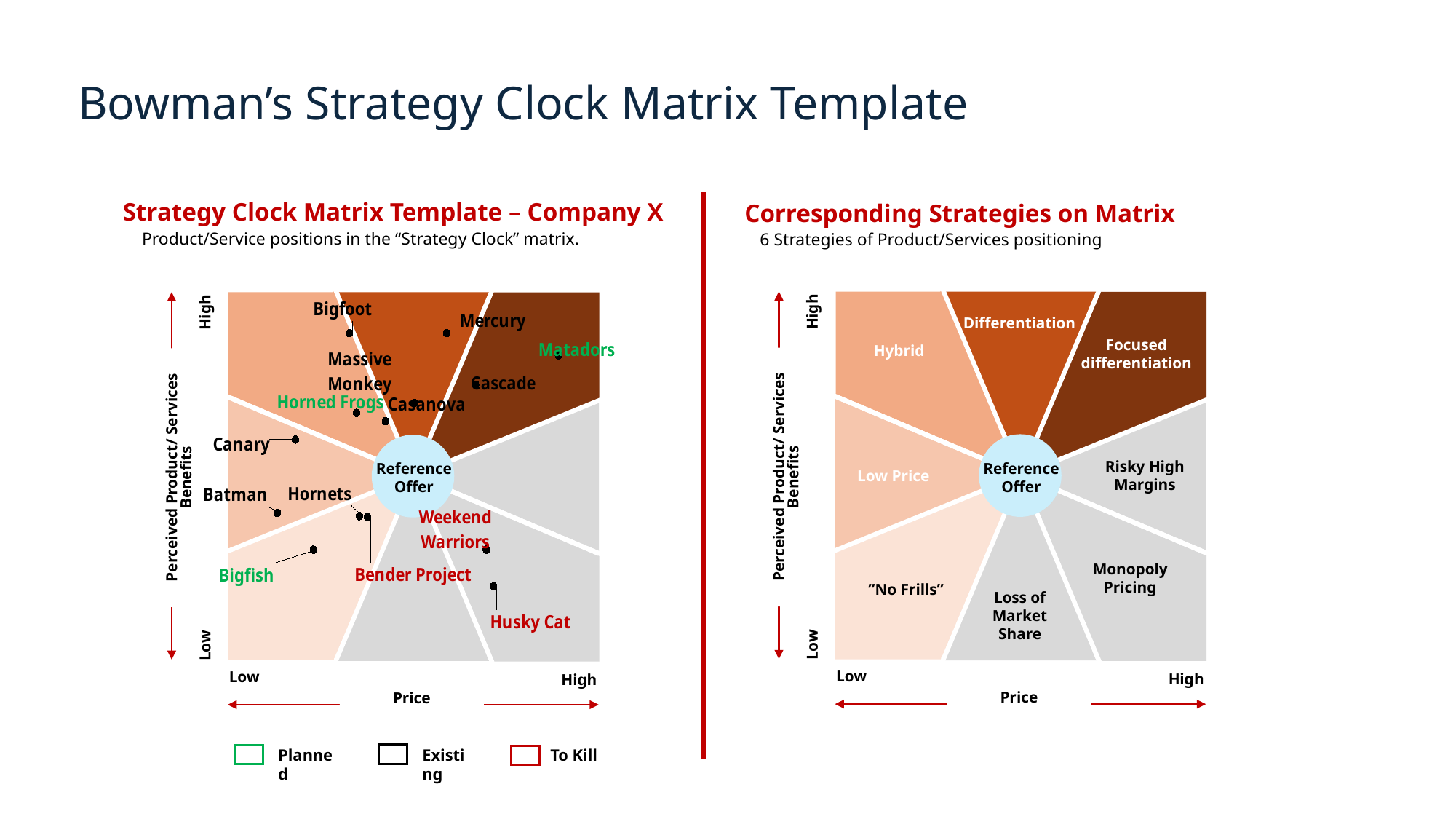
On the left chart (Strategy Clock Matrix Template – Company X), how many named products/services are plotted? 14 On the left chart (Strategy Clock Matrix Template – Company X), which products are shown in red as To Kill? Weekend Warriors, Bender Project, Husky Cat On the left chart (Strategy Clock Matrix Template – Company X), which product has the lowest perceived product/service benefits? Husky Cat On the left chart (Strategy Clock Matrix Template – Company X), how many entries does the legend list? 3 On the left chart (Strategy Clock Matrix Template – Company X), which product is positioned at the highest price? Matadors On the right chart (Corresponding Strategies on Matrix), how many strategy segments surround the Reference Offer? 8 On the right chart (Corresponding Strategies on Matrix), which strategy occupies the low-price, low-benefit corner? "No Frills" On the right chart (Corresponding Strategies on Matrix), which strategy occupies the high-price, high-benefit corner? Focused differentiation On the left chart (Strategy Clock Matrix Template – Company X), which has higher perceived benefits, Bigfoot or Bigfish? Bigfoot On the left chart (Strategy Clock Matrix Template – Company X), what are the three legend entries? Planned, Existing, To Kill On the left chart (Strategy Clock Matrix Template – Company X), which products are shown in green as Planned? Matadors, Horned Frogs, Bigfish On the left chart (Strategy Clock Matrix Template – Company X), which is positioned at a higher price, Canary or Cascade? Cascade